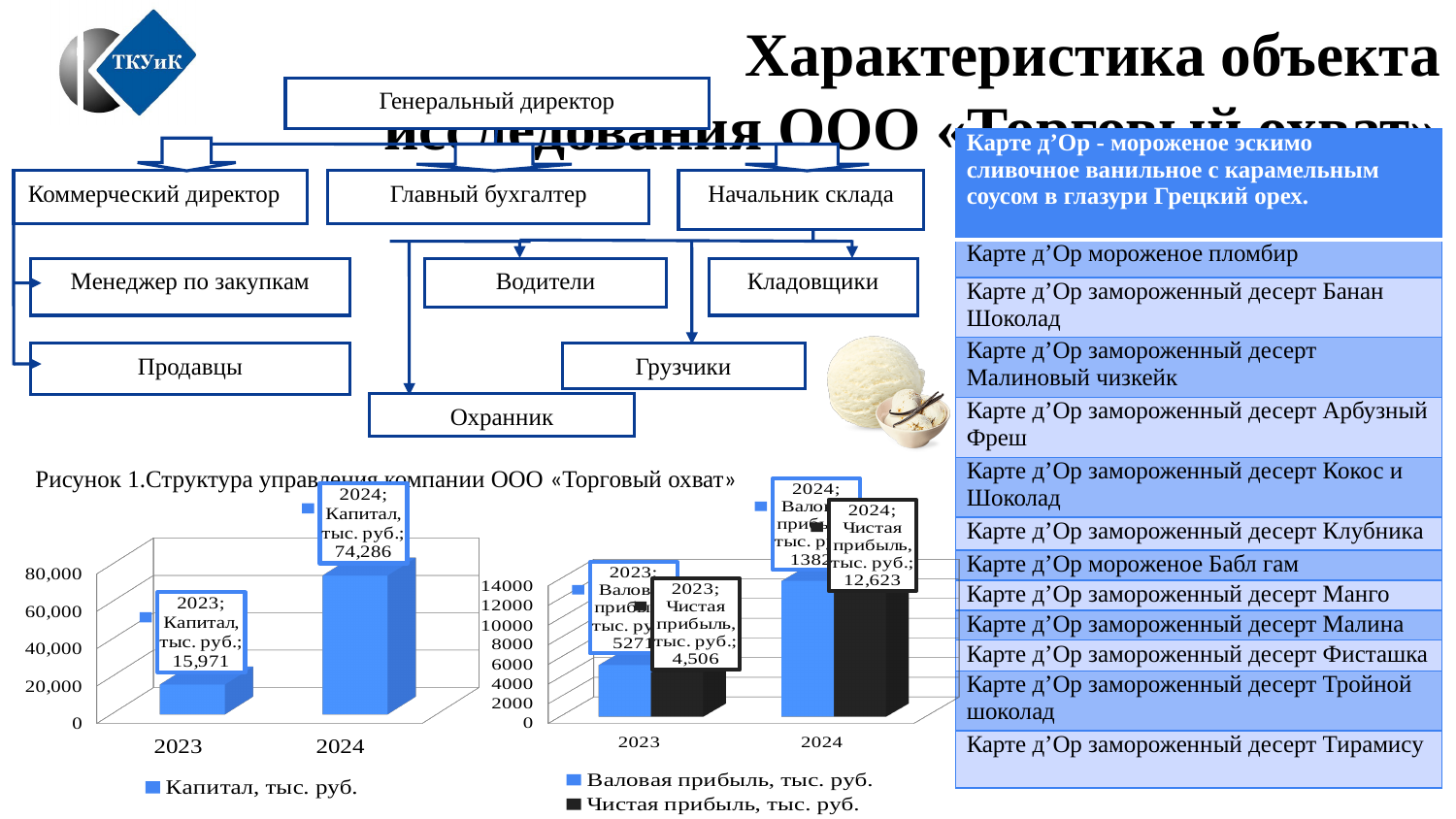
What kind of chart is the left chart (Капитал, тыс. руб.)? bar chart In the right chart, what is the value of Чистая прибыль, тыс. руб. for 2024? 12,623 In the left chart (Капитал, тыс. руб.), what is the value for 2023? 15,971 In the left chart (Капитал, тыс. руб.), by how much does the 2024 value exceed the 2023 value? 58,315 In the left chart (Капитал, тыс. руб.), what is the value for 2024? 74,286 In the left chart (Капитал, тыс. руб.), is the value for 2024 greater or less than 60,000? greater In the right chart, is Валовая прибыль for 2024 greater or less than 12000? greater In the right chart, how many series does the legend list? 2 In the right chart, what is the value of Чистая прибыль, тыс. руб. for 2023? 4,506 In the right chart, which is larger for 2023: Валовая прибыль or Чистая прибыль? Валовая прибыль In the left chart (Капитал, тыс. руб.), does the value rise or fall from 2023 to 2024? rise In the left chart (Капитал, тыс. руб.), which year has the higher value? 2024